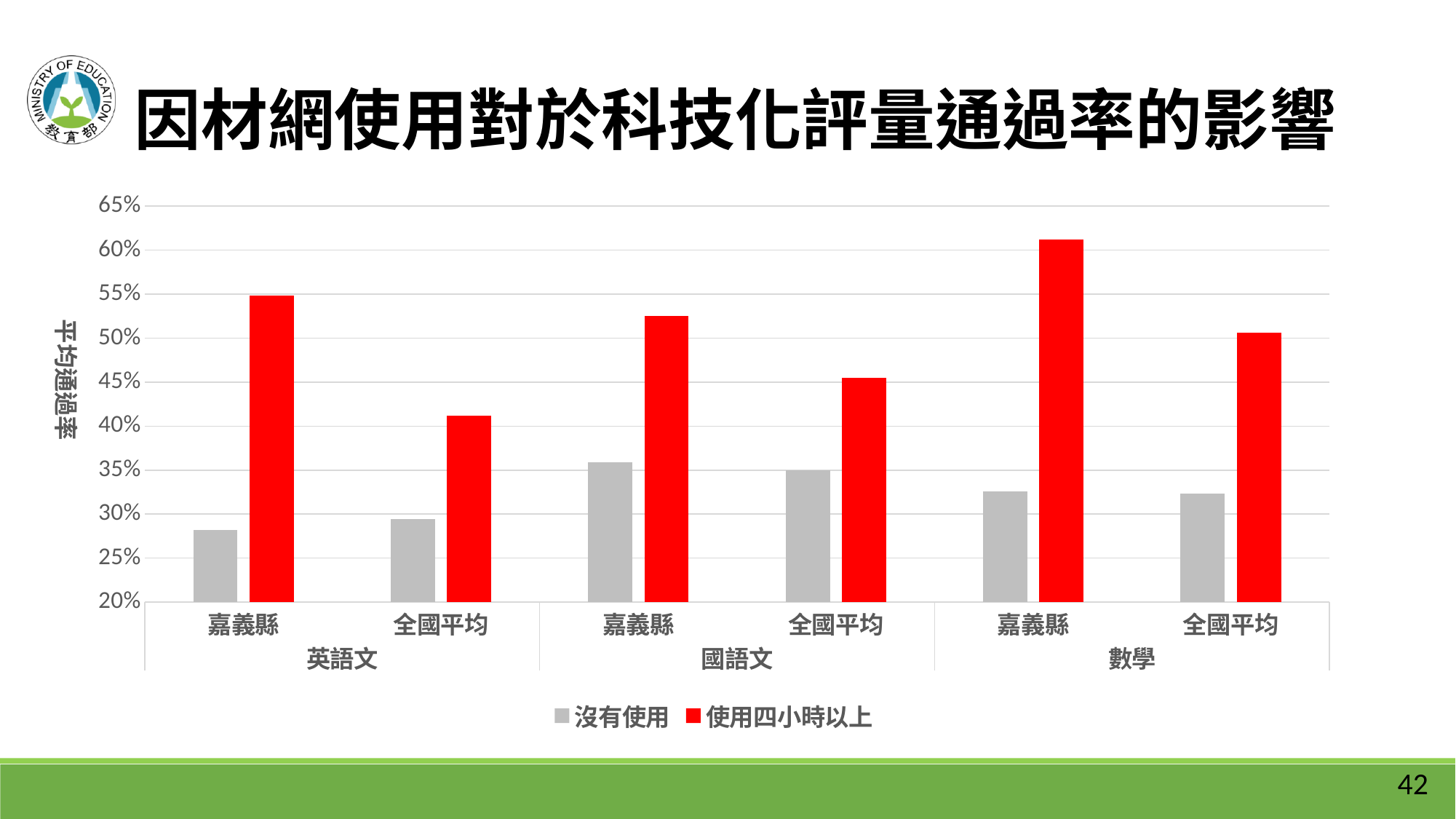
What are the two series named in the legend? 沒有使用 and 使用四小時以上 Is the 使用四小時以上 value for 英語文 全國平均 greater or less than 45%? less For 英語文, which has the larger 使用四小時以上 value, 嘉義縣 or 全國平均? 嘉義縣 How many subject groups are shown along the x axis? 3 Is the 使用四小時以上 value for 數學 嘉義縣 greater or less than 55%? greater Is the 沒有使用 value for 英語文 嘉義縣 greater or less than 30%? less How many series does the legend list? 2 Which subject and region has the highest 使用四小時以上 bar? 數學 嘉義縣 Which subject and region has the lowest 使用四小時以上 bar? 英語文 全國平均 What kind of chart is shown on the slide? bar chart Which subject and region has the lowest 沒有使用 bar? 英語文 嘉義縣 Which is larger, the 使用四小時以上 value for 數學 嘉義縣 or for 國語文 嘉義縣? 數學 嘉義縣